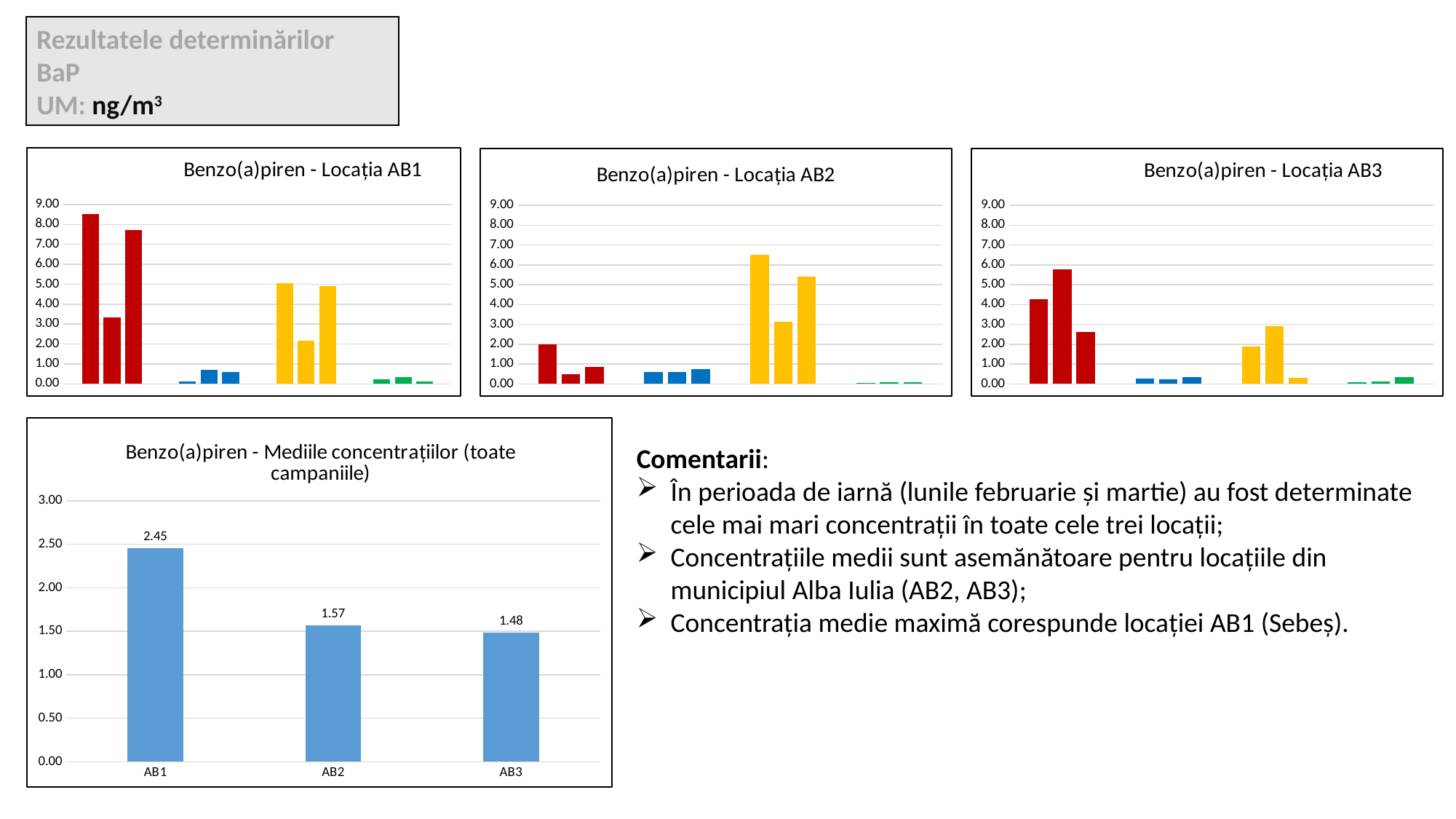
In the chart 'Benzo(a)piren - Mediile concentrațiilor (toate campaniile)', what is the value for AB2? 1.57 In the chart 'Benzo(a)piren - Locația AB1', is the tallest bar greater or less than 8.00? greater In the chart 'Benzo(a)piren - Mediile concentrațiilor (toate campaniile)', what is the value for AB3? 1.48 In the chart 'Benzo(a)piren - Locația AB2', is the tallest bar greater or less than 6.00? greater In the chart 'Benzo(a)piren - Mediile concentrațiilor (toate campaniile)', do the values rise or fall from AB1 to AB3? Fall In the chart 'Benzo(a)piren - Mediile concentrațiilor (toate campaniile)', what is the value for AB1? 2.45 What kind of chart is 'Benzo(a)piren - Mediile concentrațiilor (toate campaniile)'? Bar chart In the chart 'Benzo(a)piren - Mediile concentrațiilor (toate campaniile)', what is the difference between the values for AB2 and AB3? 0.09 In the chart 'Benzo(a)piren - Mediile concentrațiilor (toate campaniile)', which location has the highest value? AB1 In the chart 'Benzo(a)piren - Mediile concentrațiilor (toate campaniile)', which location has the lowest value? AB3 In the chart 'Benzo(a)piren - Mediile concentrațiilor (toate campaniile)', what is the difference between the values for AB1 and AB2? 0.88 In the chart 'Benzo(a)piren - Mediile concentrațiilor (toate campaniile)', how many locations are shown? 3